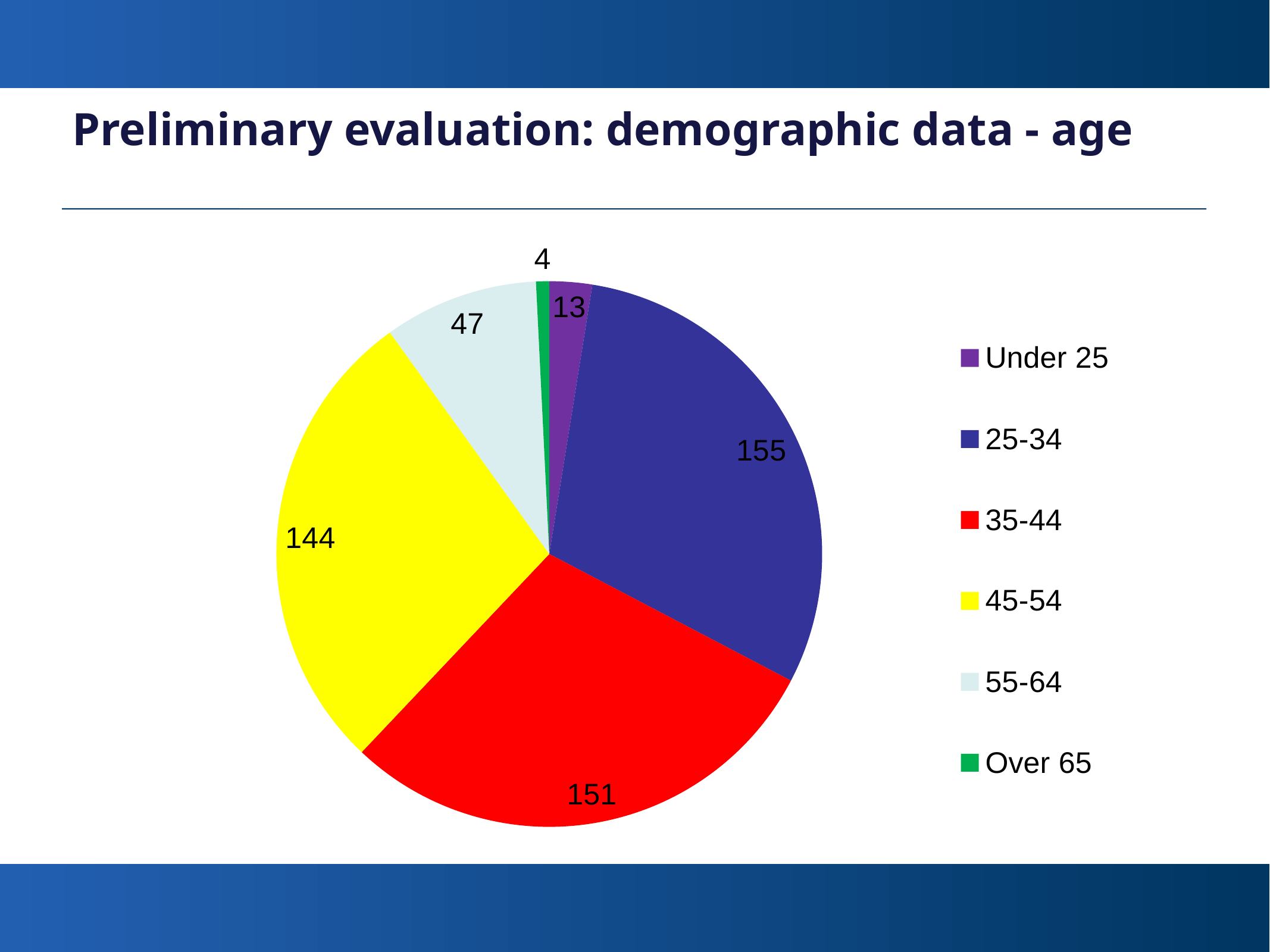
What kind of chart is shown on the slide? pie chart What is the total of all the values shown in the pie chart? 514 How many age groups are shown in the pie chart? 6 Which age group has the smallest slice of the pie? Over 65 What is the value for the 25-34 age group? 155 Which age group has the largest slice of the pie? 25-34 What is the difference between the values for the 35-44 and 45-54 age groups? 7 What is the value for the Under 25 age group? 13 Which is larger, the value for 45-54 or the value for 55-64? 45-54 What is the value for the Over 65 age group? 4 What is the value for the 55-64 age group? 47 What colour is the slice for the 35-44 age group? red